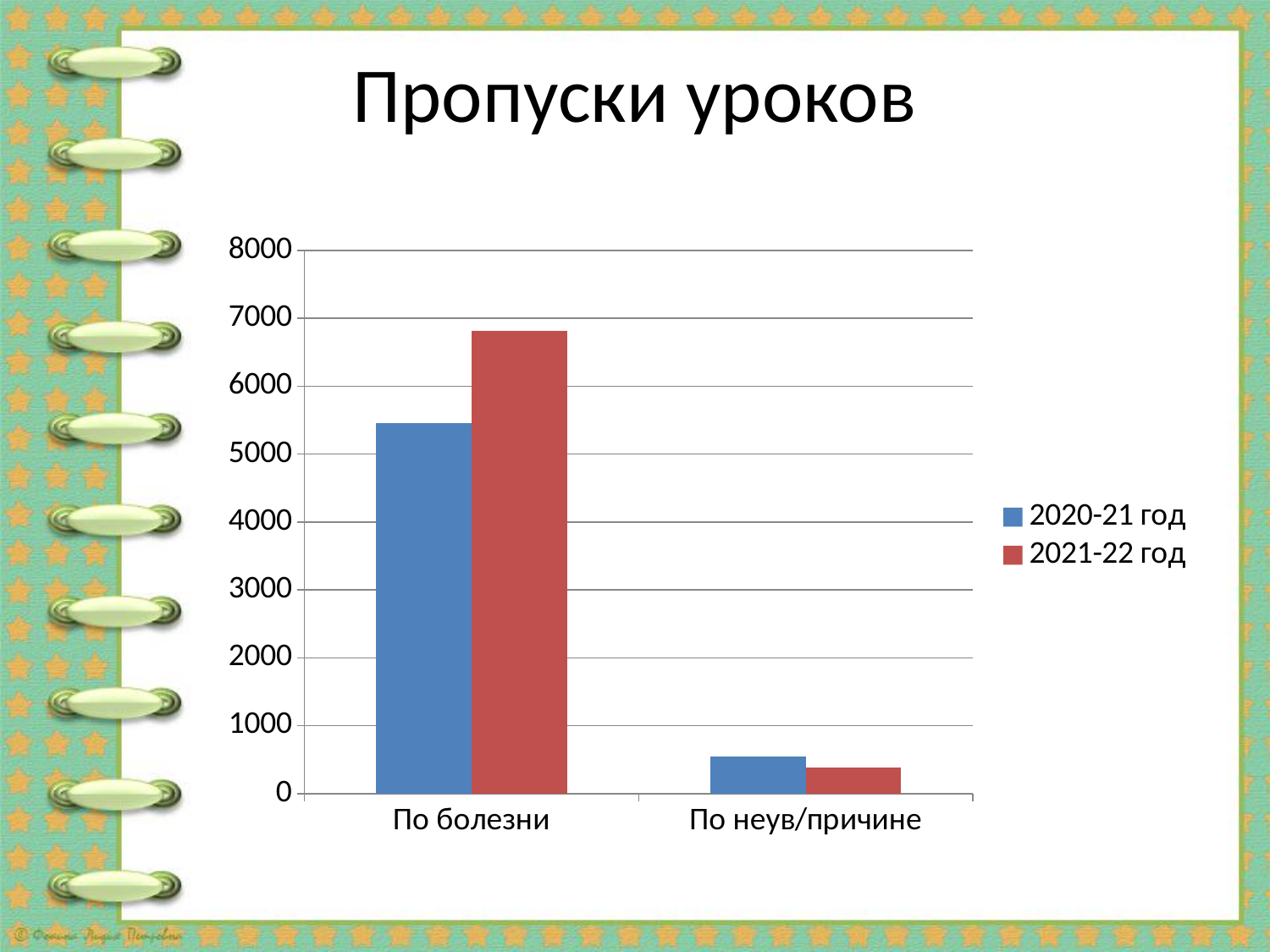
For the category По неув/причине, which series has the larger value: 2020-21 год or 2021-22 год? 2020-21 год Which series is shown in red in the legend? 2021-22 год Is the value for По болезни in 2021-22 год greater or less than 6000? greater Is the value for По неув/причине in 2020-21 год greater or less than 1000? less Is the value for По болезни in 2020-21 год greater or less than 6000? less Which category has the lowest value for the series 2020-21 год? По неув/причине How many categories are shown on the x axis? 2 For the category По болезни, which series has the larger value: 2020-21 год or 2021-22 год? 2021-22 год Which category has the highest value for the series 2021-22 год? По болезни How many series does the legend list? 2 What kind of chart is shown on the slide? bar chart What is the title of the chart? Пропуски уроков